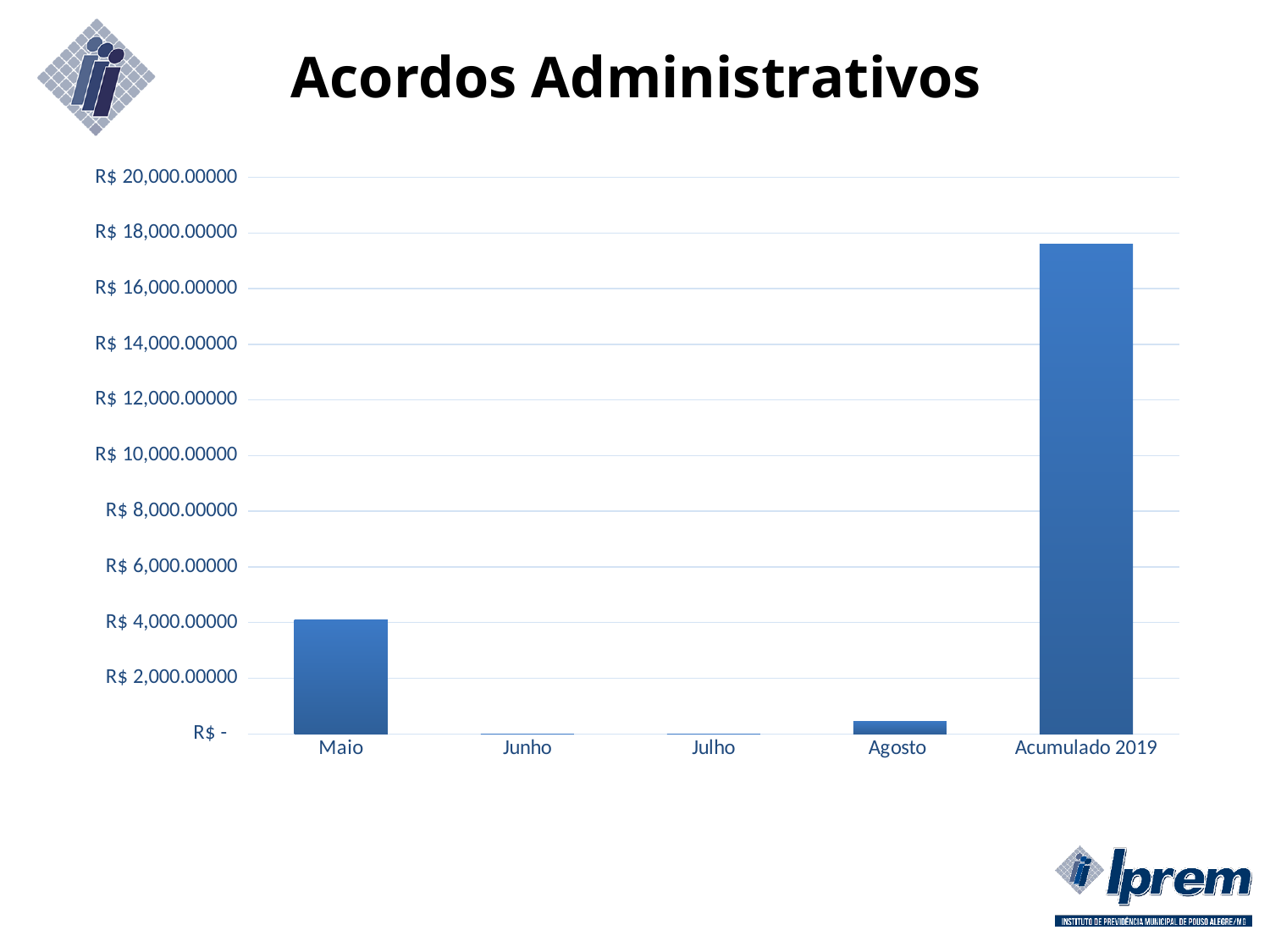
Is the value for Acumulado 2019 greater or less than R$ 16,000.00000? greater Is the value for Agosto greater or less than R$ 2,000.00000? less Which is larger, the value for Acumulado 2019 or the value for Maio? Acumulado 2019 Which category has the highest value in the chart? Acumulado 2019 What is the highest value shown on the y axis of the chart? R$ 20,000.00000 What kind of chart is shown on the slide? bar chart Which is larger, the value for Maio or the value for Agosto? Maio How many categories are shown on the x axis of the chart? 5 Is the value for Acumulado 2019 greater or less than R$ 18,000.00000? less What is the title of the slide containing the chart? Acordos Administrativos